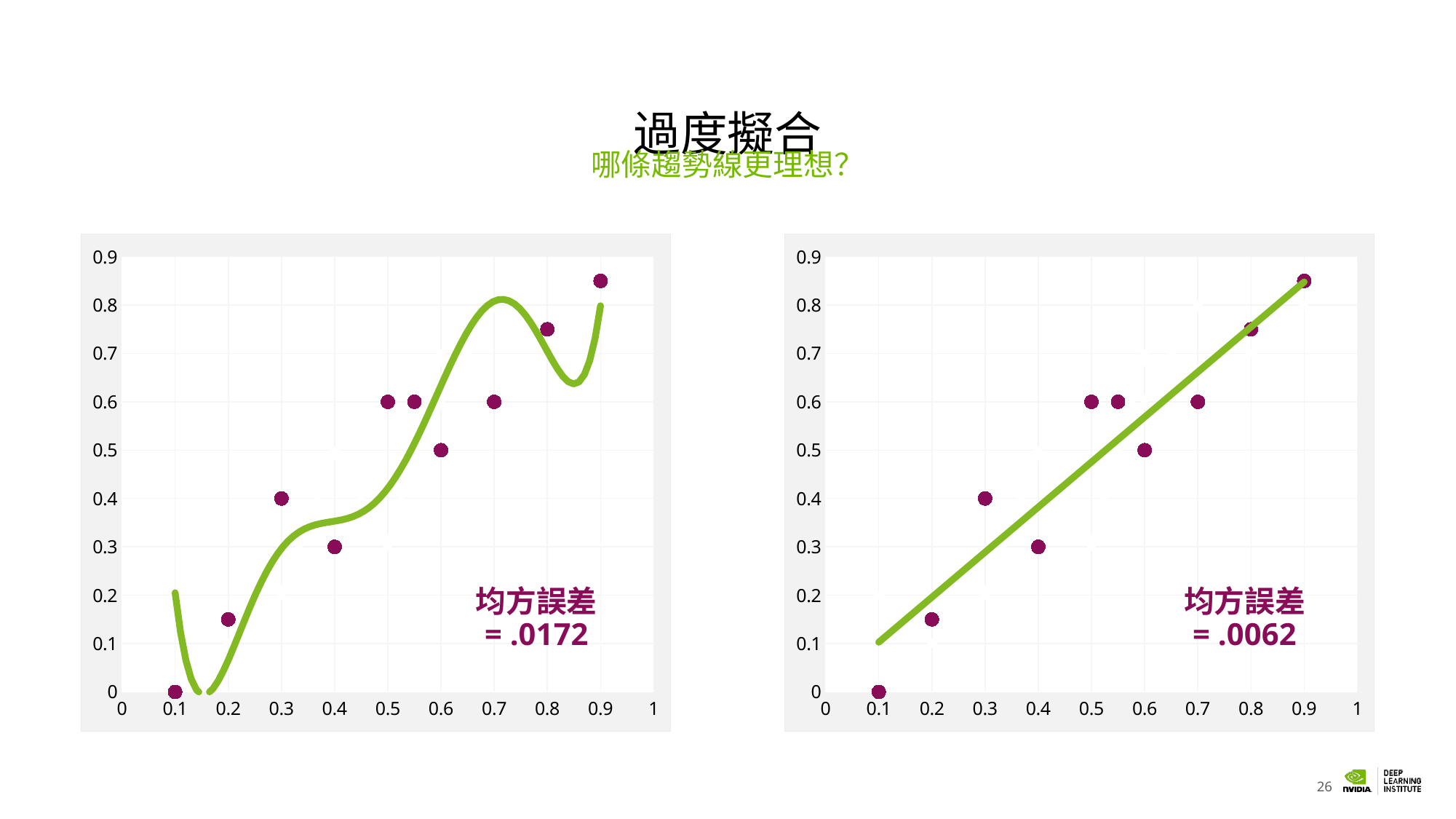
What kind of chart is shown on the left of the slide? scatter chart In the left chart, what is the y value of the point at x = 0.4? 0.3 In the right chart, what is the y value of the point at x = 0.3? 0.4 In the right chart, do the data points generally rise or fall as x increases? rise Which chart has the larger mean squared error, the left chart or the right chart? the left chart How many data points are plotted in the left chart? 10 In the left chart, what is the mean squared error (均方誤差) printed on the chart? .0172 In the right chart, what is the mean squared error (均方誤差) printed on the chart? .0062 In the right chart, what is the y value of the point at x = 0.6? 0.5 In the right chart, is the y value of the point at x = 0.8 greater or less than 0.7? greater What is the difference between the mean squared error of the left chart and that of the right chart? .0110 In the left chart, at which x value is the highest data point? 0.9